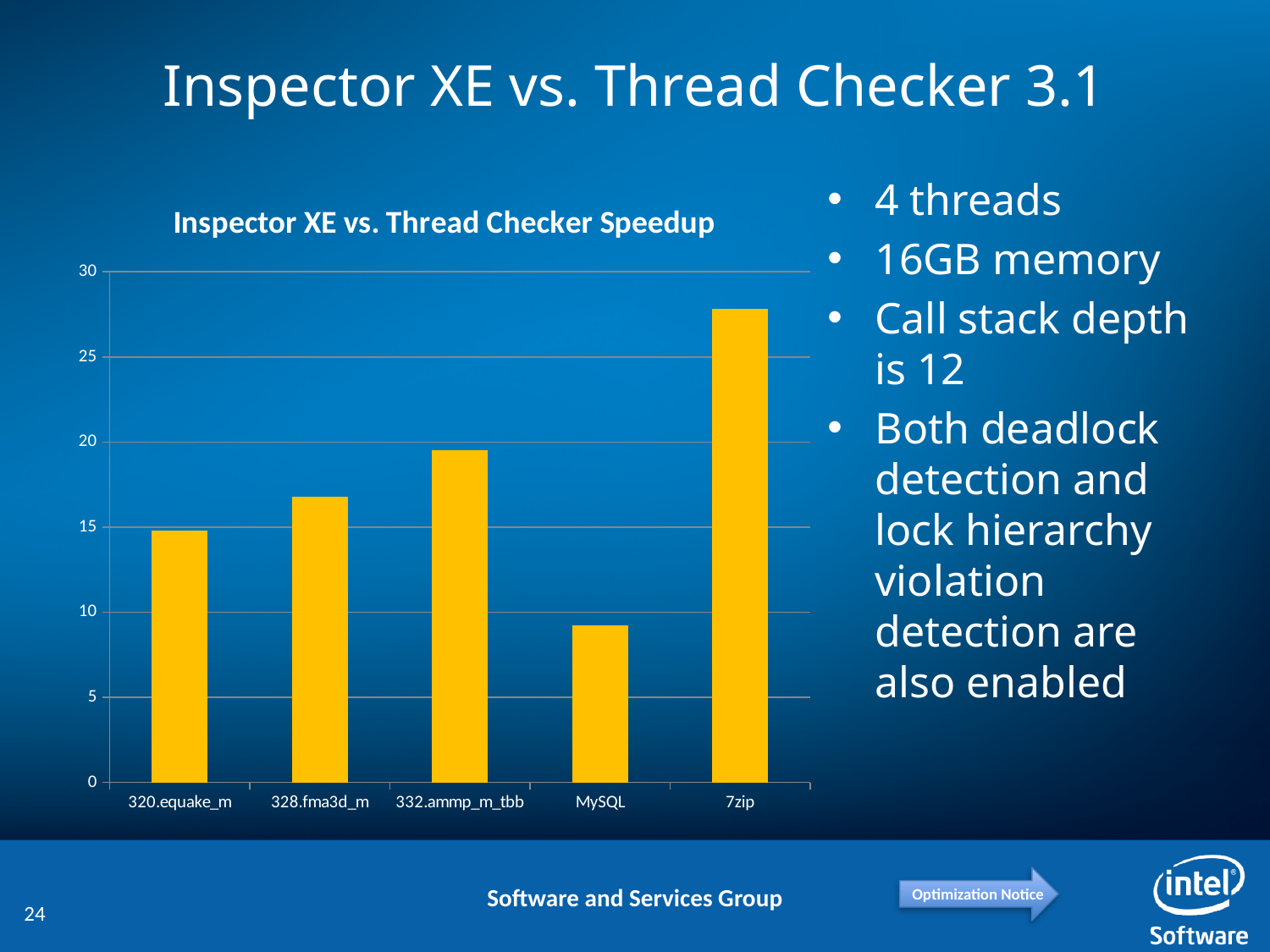
Which has the larger speedup, 328.fma3d_m or 332.ammp_m_tbb? 332.ammp_m_tbb Which has the larger speedup, 320.equake_m or MySQL? 320.equake_m Which category has the highest speedup in the chart? 7zip What is the title of the chart? Inspector XE vs. Thread Checker Speedup What kind of chart is shown on the slide? bar chart Which category has the lowest speedup in the chart? MySQL How many categories are plotted on the x axis of the chart? 5 Is the value for 7zip greater or less than 25? greater Is the value for 332.ammp_m_tbb greater or less than 20? less Is the value for MySQL greater or less than 10? less What is the highest value shown on the chart's vertical axis? 30